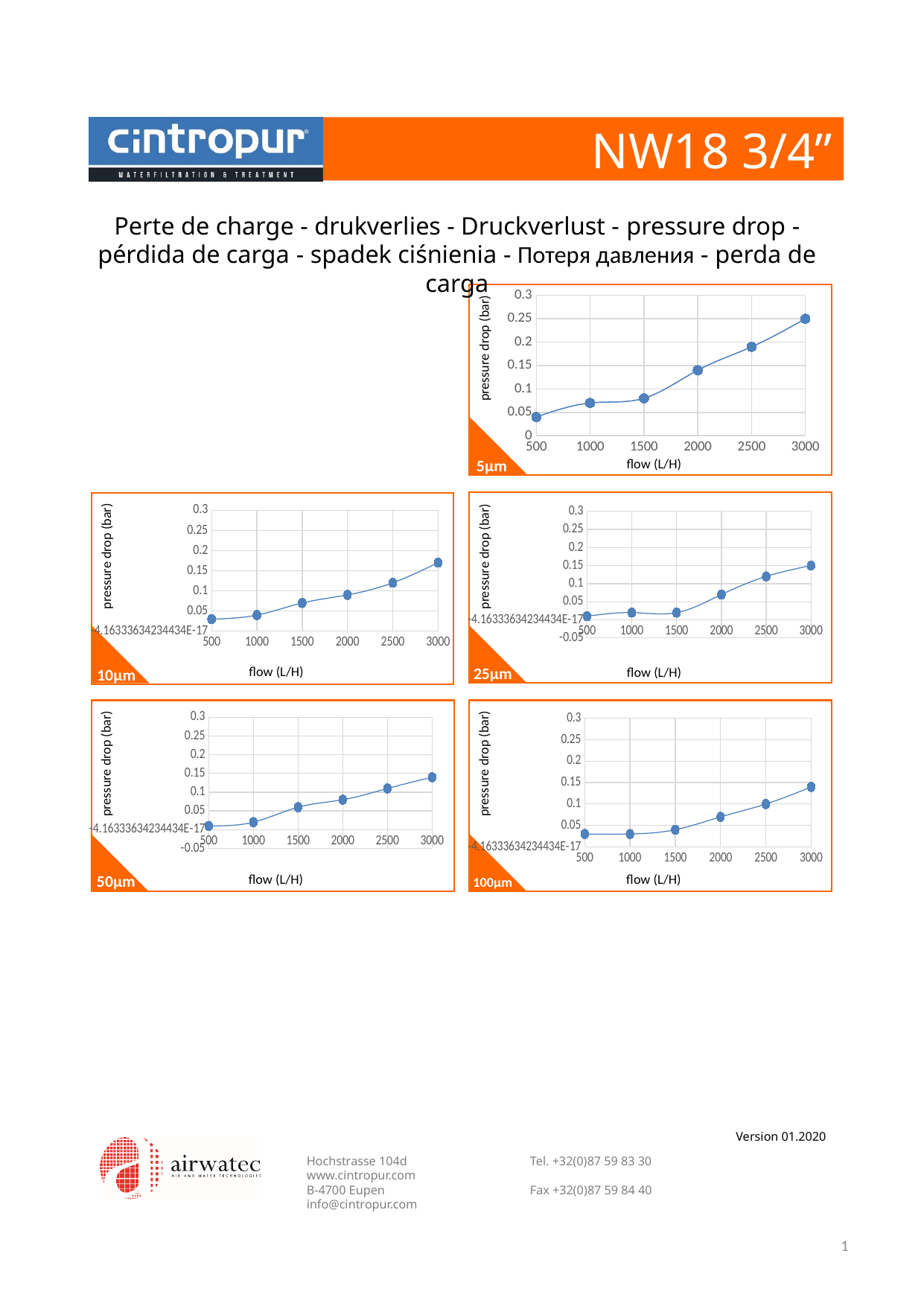
On the 100µm chart, is the pressure drop at 1000 L/H greater or less than 0.05? less What kind of chart is the 5µm chart? line chart On the 10µm chart, is the pressure drop at 3000 L/H greater or less than 0.15? greater On the 5µm chart, does the pressure drop rise or fall as flow increases from 500 to 3000 L/H? rises How many data points are plotted on the 10µm chart? 6 On the 5µm chart, at which flow is the pressure drop highest? 3000 On the 5µm chart, is the pressure drop at 3000 L/H greater or less than 0.2? greater What is the label of the y axis on the 25µm chart? pressure drop (bar) Which is larger at 3000 L/H: the pressure drop on the 5µm chart or on the 10µm chart? 5µm On the 5µm chart, at which flow is the pressure drop lowest? 500